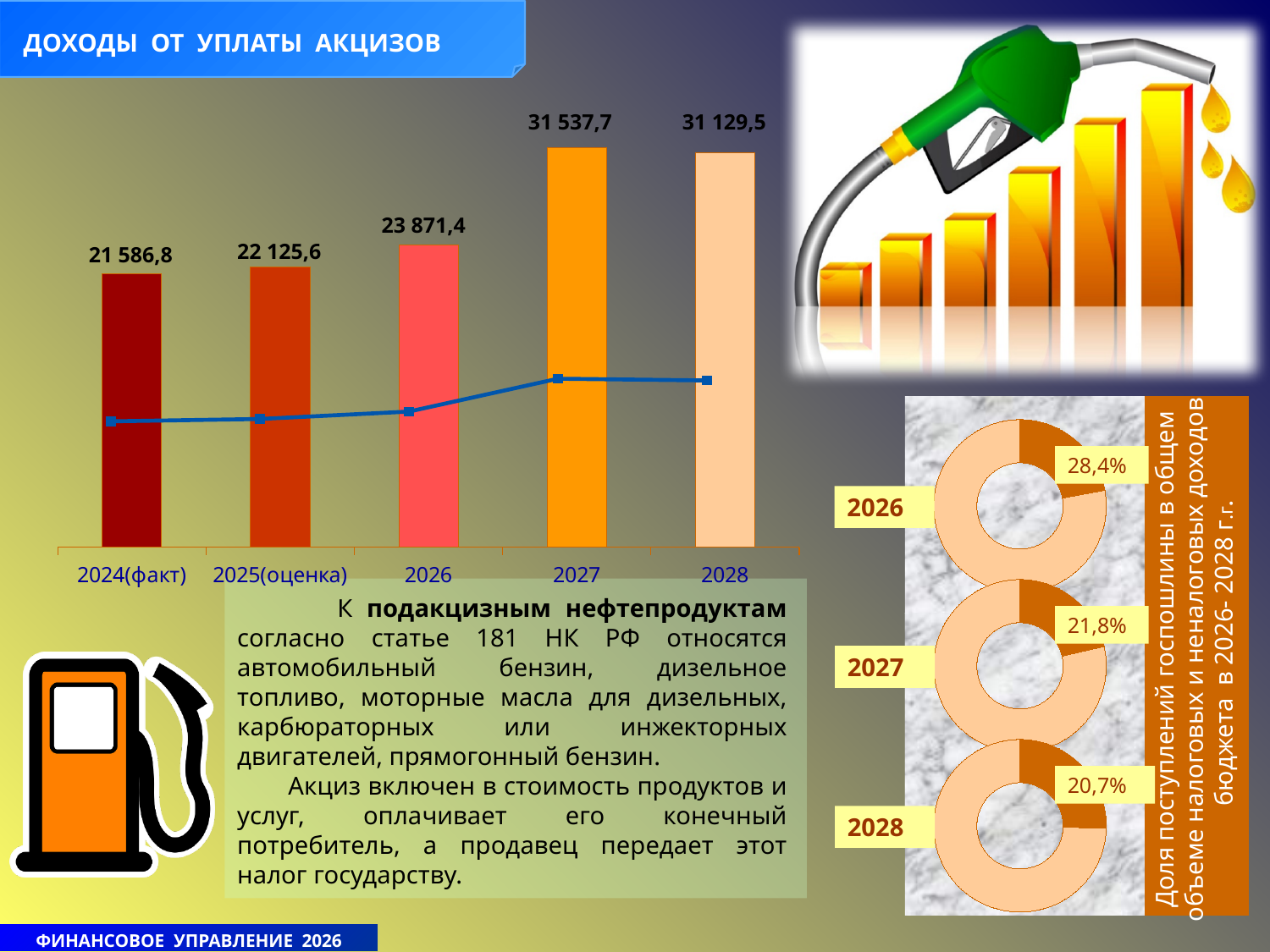
In the bar chart on the left, what is the difference between the values for 2026 and 2025(оценка)? 1 745,8 In the donut charts on the right, which year has the highest share? 2026 In the bar chart on the left, which year has the highest value? 2027 In the bar chart on the left, which is larger: the value for 2025(оценка) or the value for 2026? 2026 In the bar chart on the left, what is the value for 2028? 31 129,5 In the donut charts on the right, what is the difference between the shares for 2026 and 2028? 7,7% In the bar chart on the left, what is the value for 2026? 23 871,4 In the donut charts on the right, what is the share shown for 2027? 21,8% How many bars are shown in the bar chart on the left? 5 In the bar chart on the left, what is the value for 2024(факт)? 21 586,8 In the bar chart on the left, what is the difference between the values for 2027 and 2028? 408,2 In the bar chart on the left, which year has the lowest value? 2024(факт)